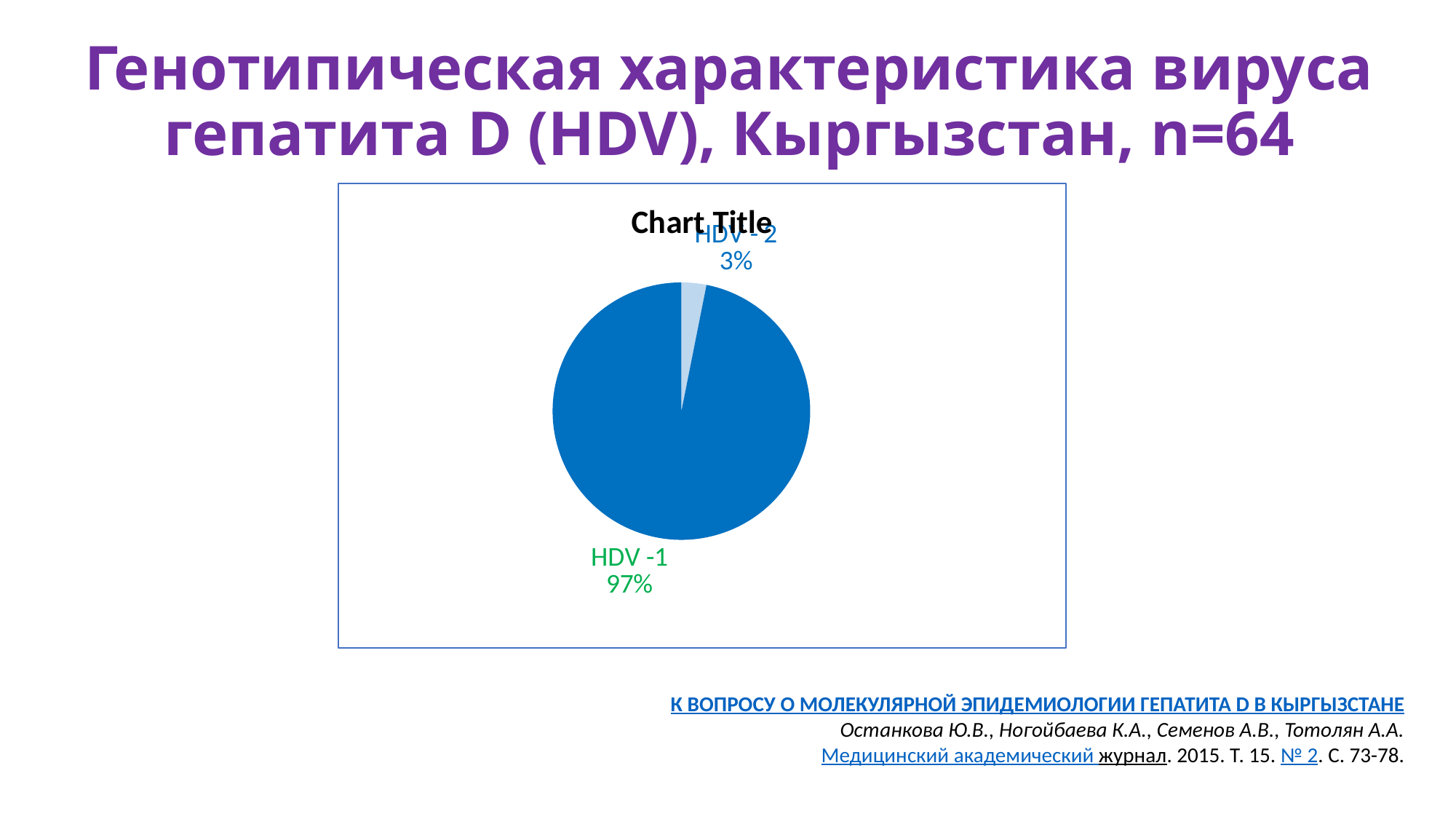
What share of the pie does HDV - 2 account for? 3% What kind of chart is shown on the slide? pie chart What share of the pie does HDV -1 account for? 97% How many slices does the pie chart have? 2 What is the difference in percentage points between the HDV -1 and HDV - 2 slices? 94 What is the title printed above the pie chart? Chart Title Which genotype has the largest slice of the pie? HDV -1 Which genotype has the smallest slice of the pie? HDV - 2 What is the sample size (n) stated in the slide title? 64 Which slice is larger, HDV -1 or HDV - 2? HDV -1